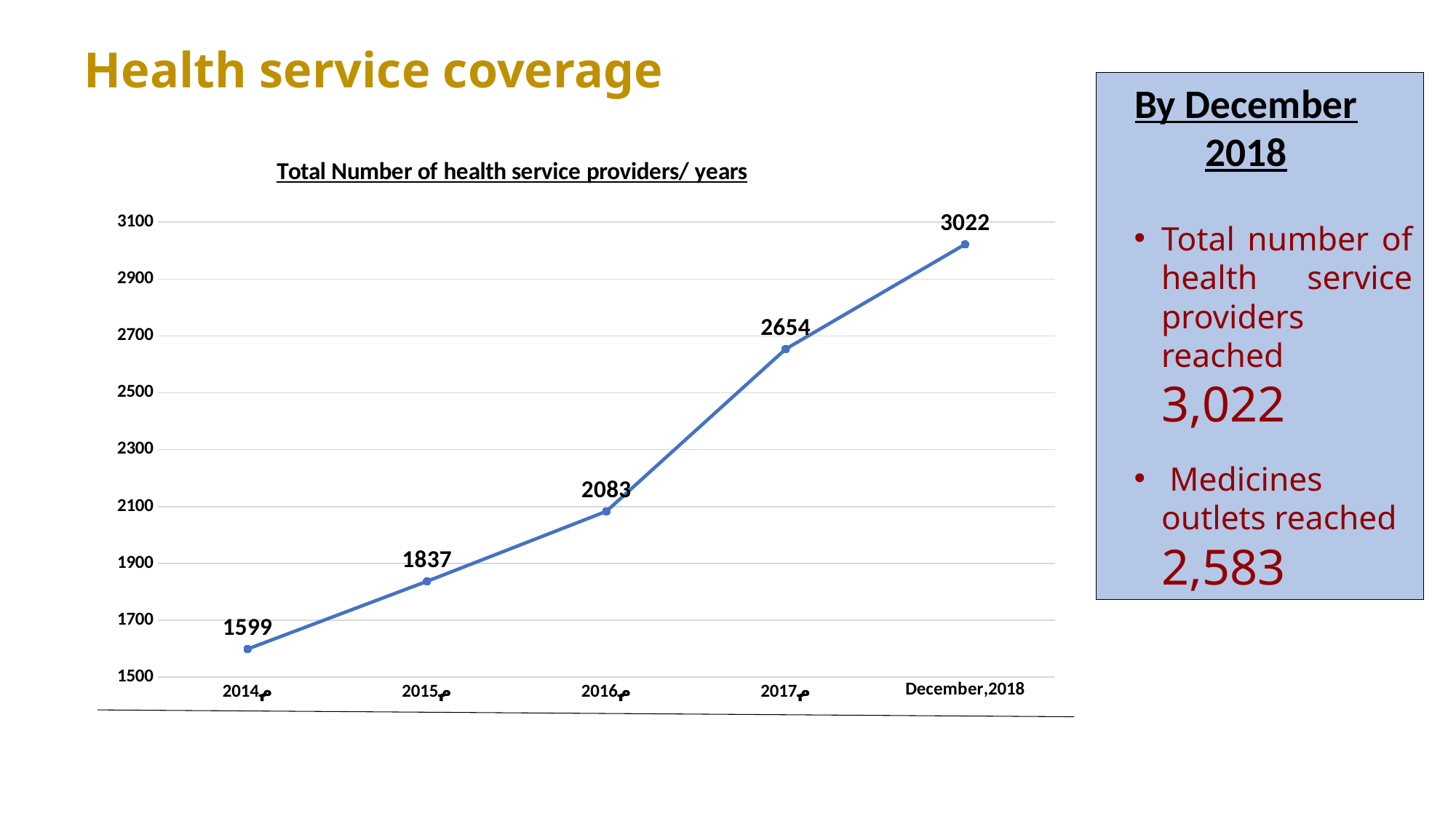
What is the total number of health service providers in 2014? 1599 What kind of chart is shown on the slide? Line chart What is the total number of health service providers in 2016? 2083 What is the difference in the number of health service providers between 2017 and 2016? 571 How many data points are plotted on the chart? 5 What is the title of the chart? Total Number of health service providers/ years What is the total number of health service providers in December 2018? 3022 Which year has the lowest number of health service providers? 2014 Which year has more health service providers, 2015 or 2017? 2017 Does the number of health service providers rise or fall from 2014 to December 2018? Rise What is the difference in the number of health service providers between December 2018 and 2014? 1423 Which year has the highest number of health service providers? December, 2018